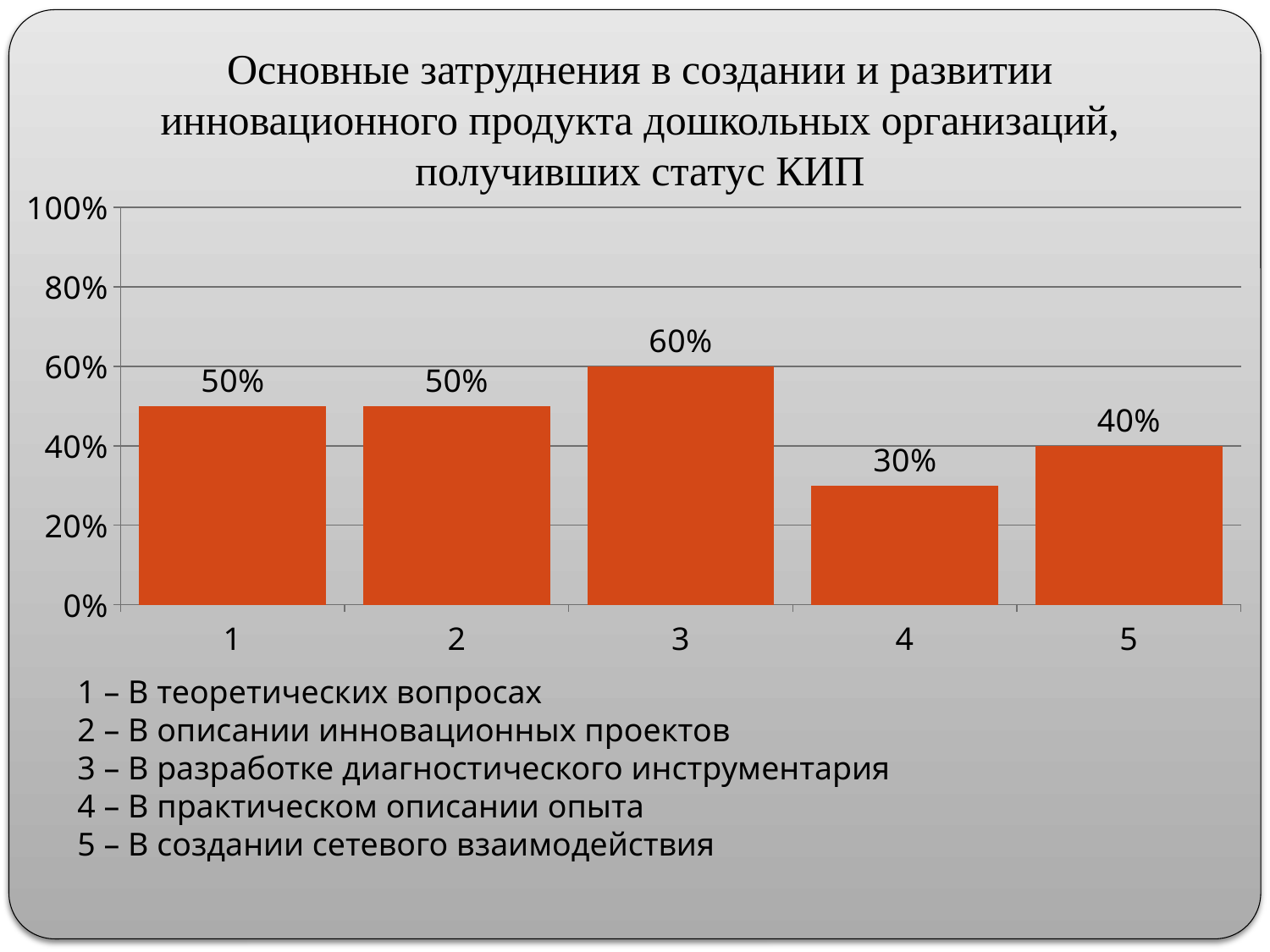
How many categories (bars) are shown in the chart? 5 What is the difference between the values for category 3 and category 4? 30% What kind of chart is shown on the slide? Bar chart What is the maximum value shown on the vertical axis? 100% What is the value for category 4 (В практическом описании опыта)? 30% Which is larger, the value for category 1 or the value for category 5? Category 1 Is the value for category 3 greater or less than 40%? greater What colour are the bars in the chart? Orange-red Which category has the lowest value? 4 Which category has the highest value? 3 What is the value for category 5 (В создании сетевого взаимодействия)? 40% What is the value for category 3 (В разработке диагностического инструментария)? 60%